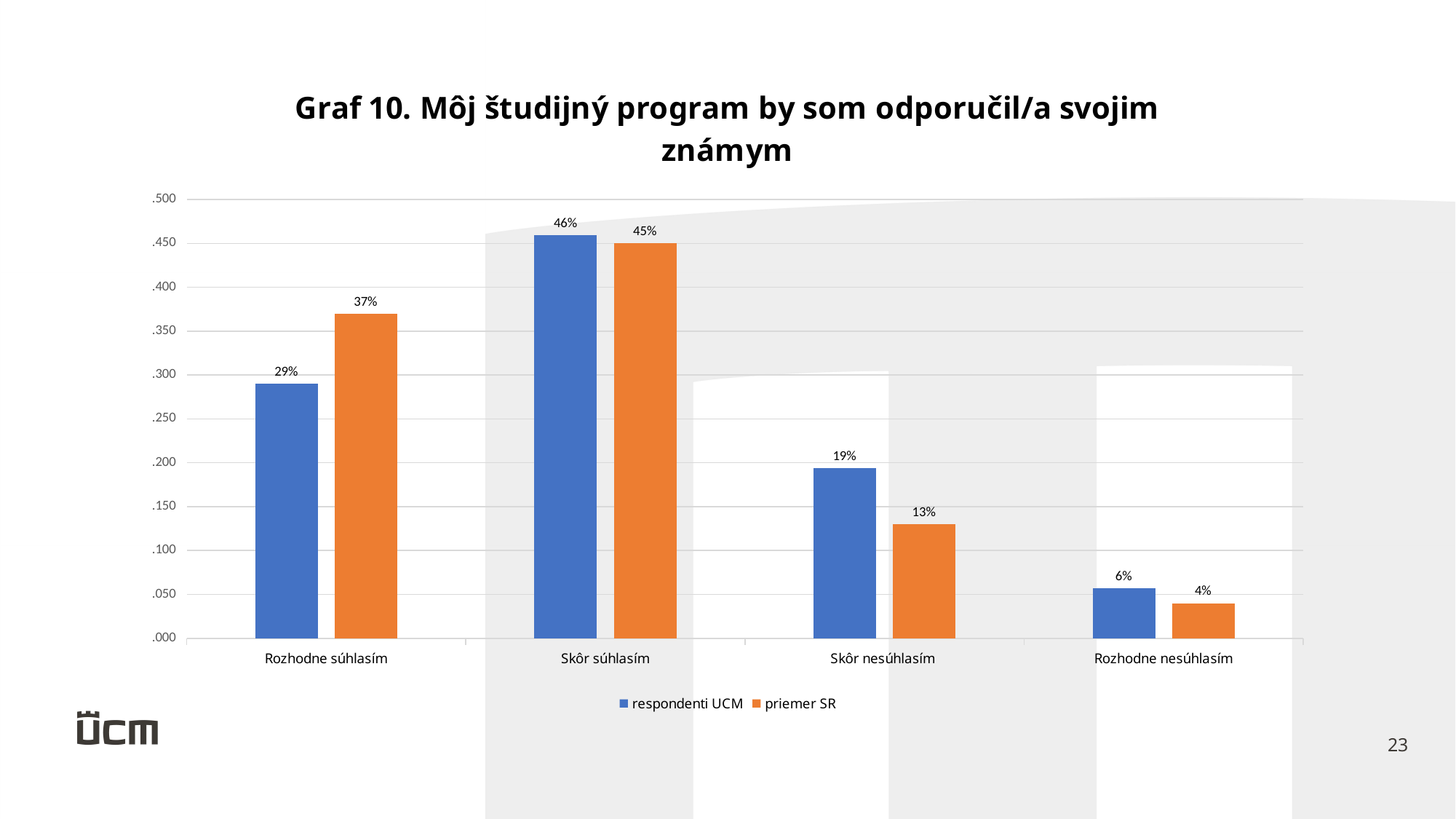
What is the value for priemer SR in the Skôr nesúhlasím category? 13% What is the value for respondenti UCM in the Rozhodne nesúhlasím category? 6% What kind of chart is shown on the slide? Bar chart What is the difference between priemer SR and respondenti UCM in the Rozhodne súhlasím category? 8% In the Skôr nesúhlasím category, which series has the larger value, respondenti UCM or priemer SR? respondenti UCM What is the value for respondenti UCM in the Rozhodne súhlasím category? 29% Which colour represents the priemer SR series? Orange How many categories are shown on the x axis? 4 What is the value for priemer SR in the Rozhodne súhlasím category? 37% Which category has the lowest value for priemer SR? Rozhodne nesúhlasím How many series does the legend list? 2 Which category has the highest value for respondenti UCM? Skôr súhlasím